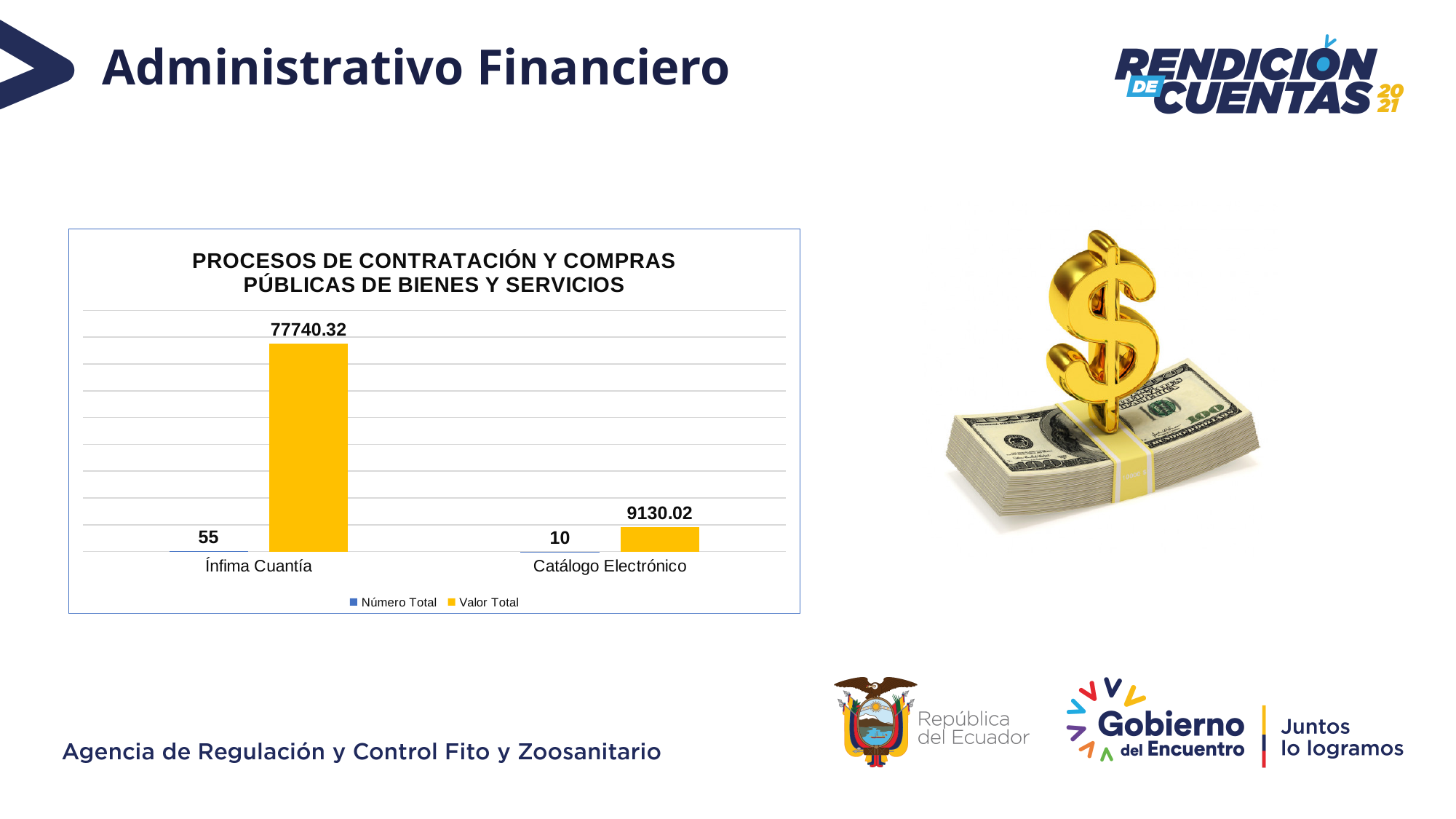
Which has a larger Valor Total, Ínfima Cuantía or Catálogo Electrónico? Ínfima Cuantía How many series does the chart legend list? 2 What is the Número Total for Catálogo Electrónico? 10 What is the Número Total for Ínfima Cuantía? 55 What is the Valor Total for Ínfima Cuantía? 77740.32 What type of chart is shown on the slide? Bar chart What is the difference in Valor Total between Ínfima Cuantía and Catálogo Electrónico? 68610.3 How many categories are shown on the x axis of the chart? 2 Which category has the lowest Número Total? Catálogo Electrónico Which category has the highest Valor Total? Ínfima Cuantía What is the Valor Total for Catálogo Electrónico? 9130.02 What is the difference in Número Total between Ínfima Cuantía and Catálogo Electrónico? 45